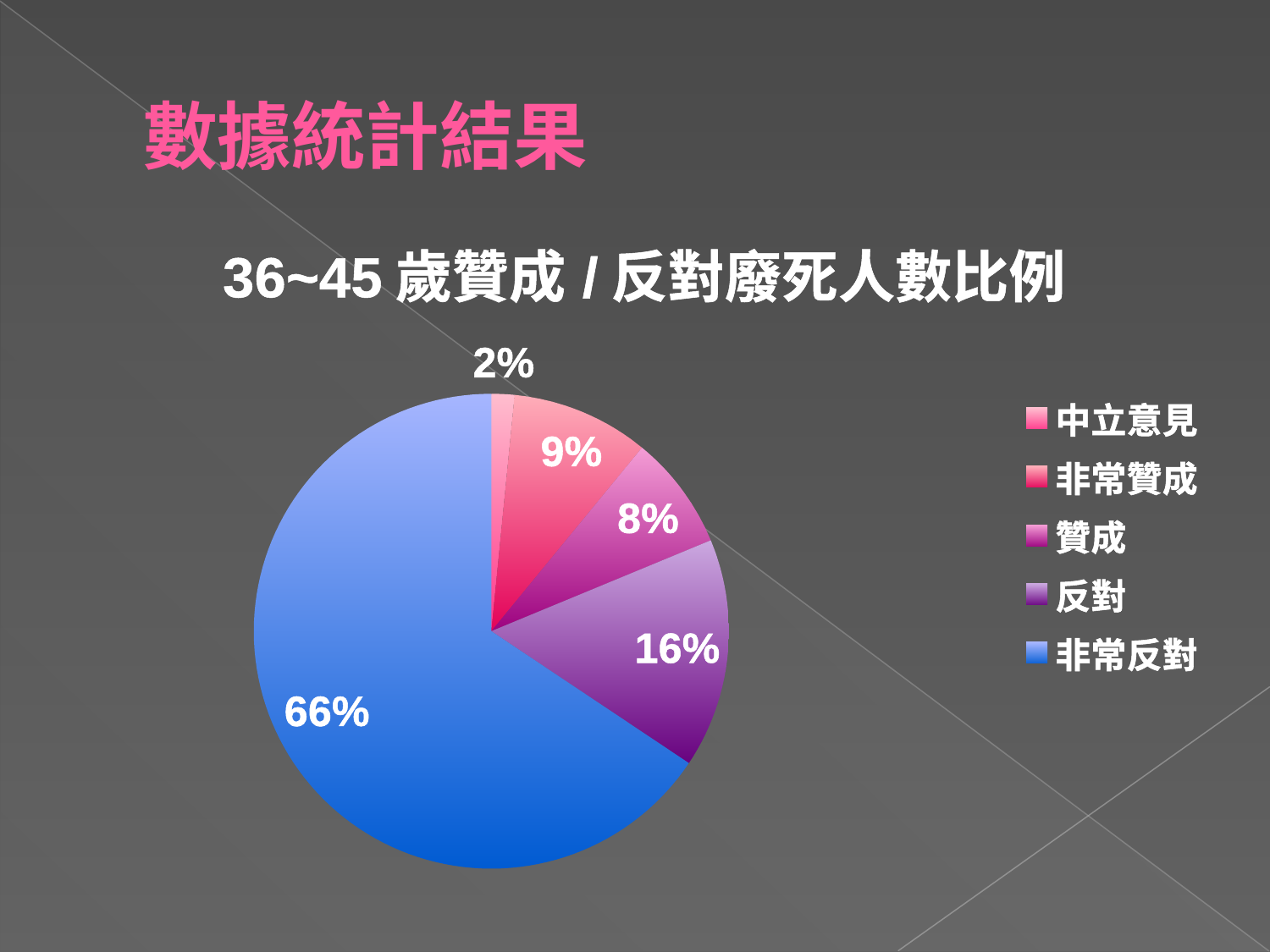
What percentage of the pie is 非常反對? 66% Which is larger, the share for 非常贊成 or the share for 贊成? 非常贊成 What percentage of the pie is 贊成? 8% What percentage of the pie is 反對? 16% Which category has the smallest share of the pie? 中立意見 What percentage of the pie is 中立意見? 2% How many categories does the legend list? 5 What percentage of the pie is 非常贊成? 9% Which category has the largest share of the pie? 非常反對 What type of chart is shown on the slide? Pie chart What is the title of the chart? 36~45 歲贊成 / 反對廢死人數比例 What is the difference in percentage points between 非常反對 and 反對? 50